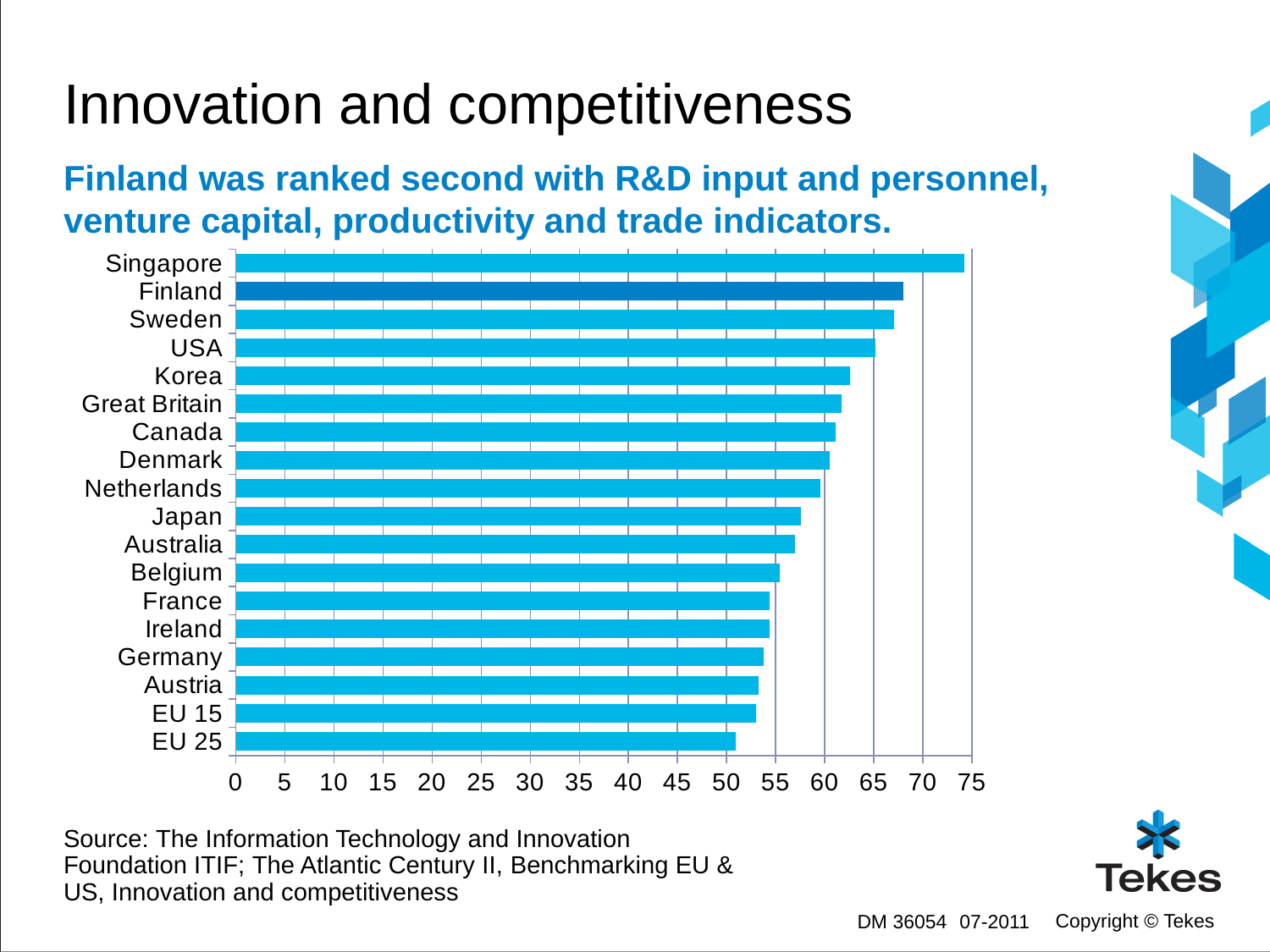
Is the value for EU 25 greater or less than 50? greater What kind of chart is shown on the slide? bar chart Which has the larger value, Belgium or USA? USA Which category has the lowest value in the bar chart? EU 25 Is the value for Singapore greater or less than 70? greater Is the value for Germany greater or less than 55? less Which country has the highest value in the bar chart? Singapore Which has the larger value, Sweden or Korea? Sweden Which country's bar is highlighted in a darker blue than the others? Finland How many countries or regions are plotted in the bar chart? 18